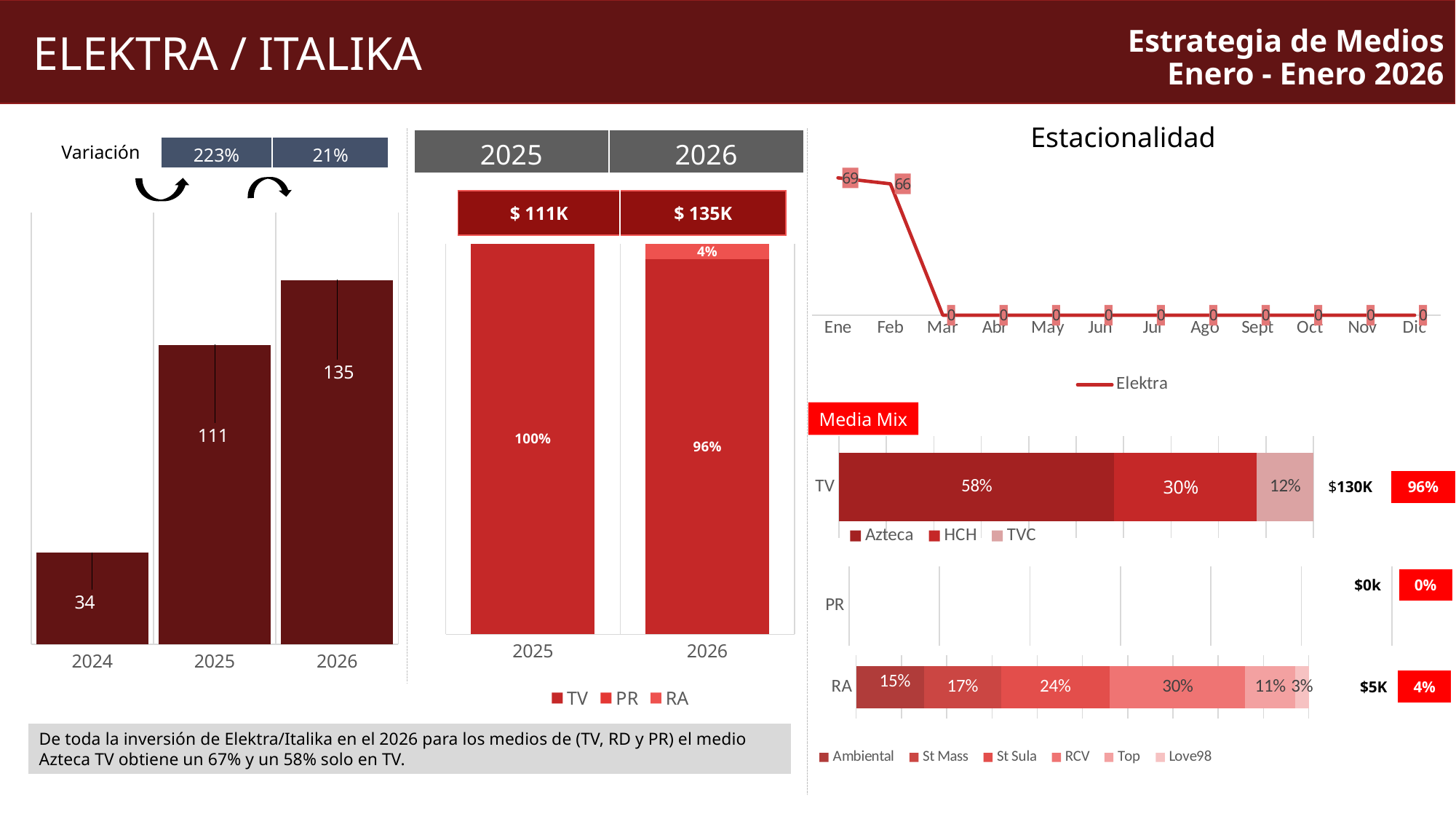
In the Estacionalidad chart, what is the value for Feb? 66 In the bar chart on the left of the slide, what is the difference between the values for 2025 and 2024? 77 In the stacked bar chart in the middle of the slide (2025 / 2026), what percentage does TV represent in 2026? 96% In the Media Mix chart, which is larger in the RA bar: St Sula or RCV? RCV In the bar chart on the left of the slide, how many years are shown? 3 In the bar chart on the left of the slide, which year has the lowest value? 2024 In the Media Mix chart, what share of the TV bar does HCH represent? 30% In the stacked bar chart in the middle of the slide (2025 / 2026), how many series does the legend list? 3 In the bar chart on the left of the slide, what is the value for 2026? 135 In the Estacionalidad chart, which month has the highest value? Ene In the bar chart on the left of the slide, do the values rise or fall from 2024 to 2026? rise What kind of chart is the Estacionalidad chart? line chart